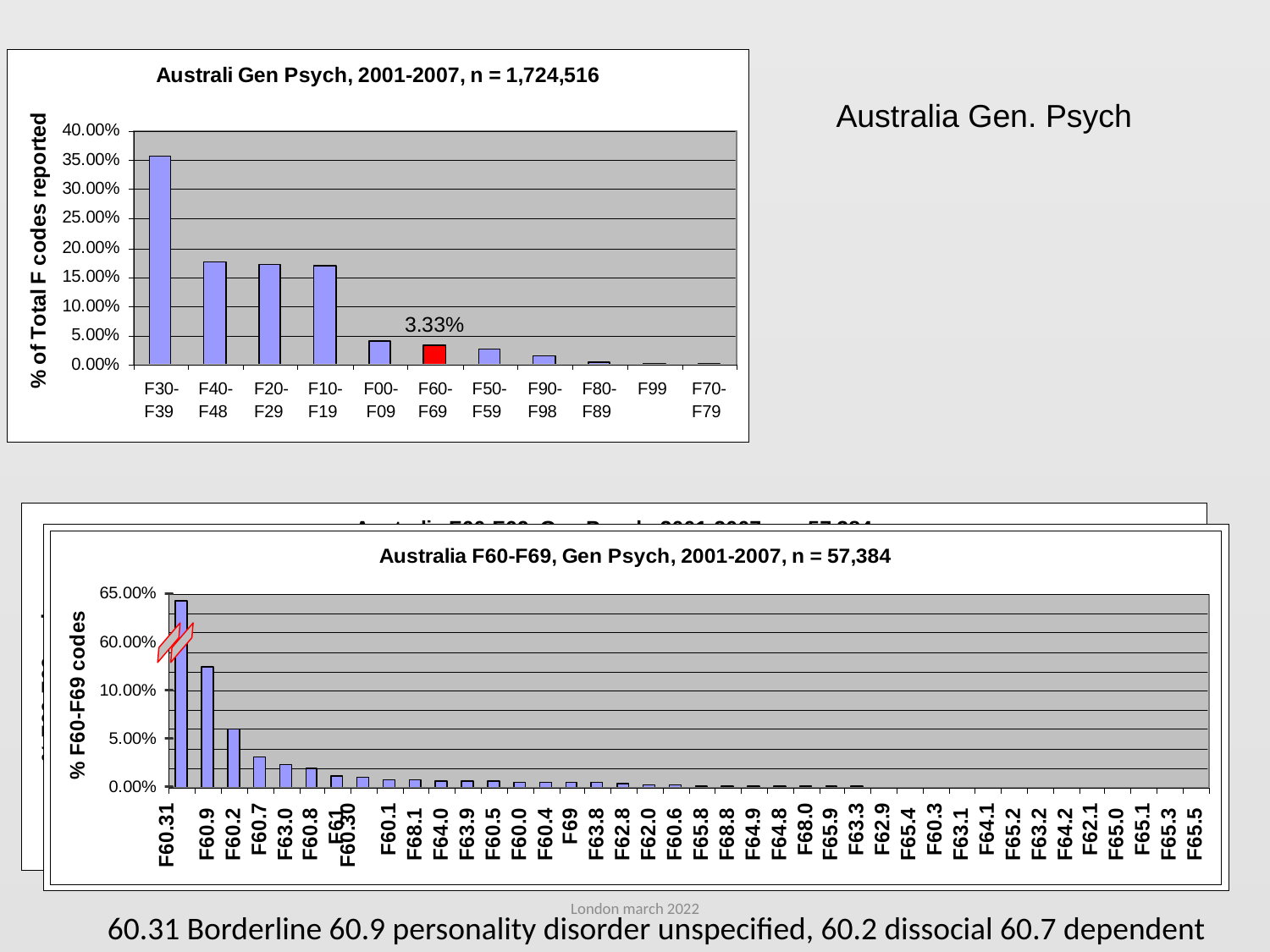
In the top chart (Australi Gen Psych, 2001-2007), which category has the highest value? F30-F39 What kind of chart is the top chart (Australi Gen Psych, 2001-2007)? Bar chart In the top chart (Australi Gen Psych, 2001-2007), what value is labelled on the F60-F69 bar? 3.33% How many categories are shown on the x axis of the top chart (Australi Gen Psych, 2001-2007)? 11 In the bottom chart (Australia F60-F69, Gen Psych, 2001-2007), which category has the highest value? F60.31 In the top chart (Australi Gen Psych, 2001-2007), is the value for F40-F48 greater or less than 20.00%? less In the top chart (Australi Gen Psych, 2001-2007), is the value for F30-F39 greater or less than 30.00%? greater In the top chart (Australi Gen Psych, 2001-2007), do the values rise or fall from left to right along the x axis? Fall In the bottom chart (Australia F60-F69, Gen Psych, 2001-2007), which is larger, the value for F60.2 or the value for F60.7? F60.2 In the top chart (Australi Gen Psych, 2001-2007), which is larger, the value for F30-F39 or the value for F40-F48? F30-F39 What is the y-axis label of the top chart (Australi Gen Psych, 2001-2007)? % of Total F codes reported